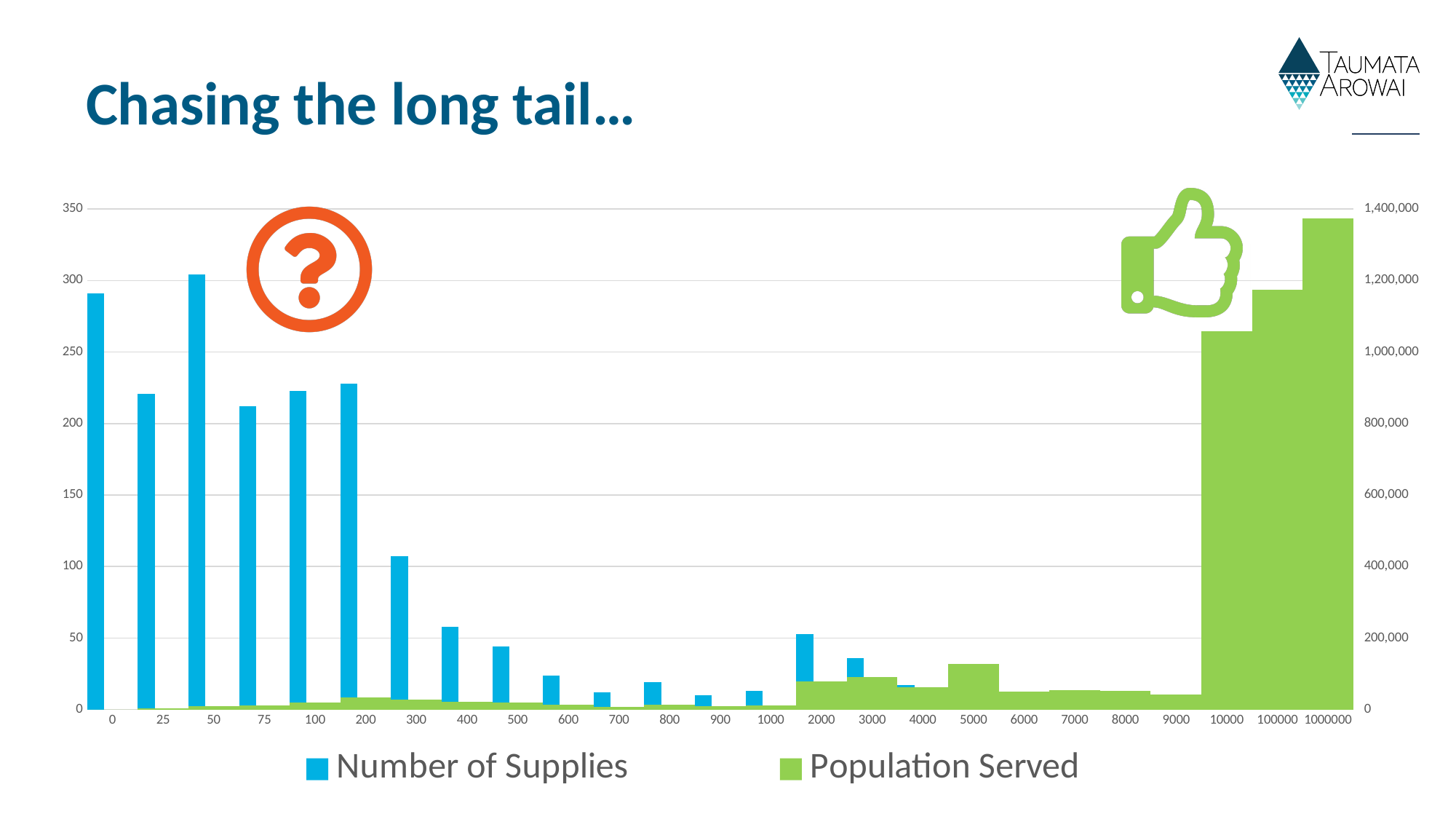
Do the Number of Supplies values rise or fall from category 200 to category 900? fall What is the title of the slide containing the chart? Chasing the long tail… Is the Number of Supplies value for category 0 greater or less than 250? greater What are the two series named in the legend? Number of Supplies and Population Served Which category has the highest value for Number of Supplies? 50 Which category has the highest value for Population Served? 1000000 Is the Population Served value for category 1000000 greater or less than 1,200,000? greater Is the Population Served value for category 10000 greater or less than 800,000? greater How many categories are shown on the x axis? 25 How many series does the legend list? 2 Which has the larger Number of Supplies value, category 0 or category 25? 0